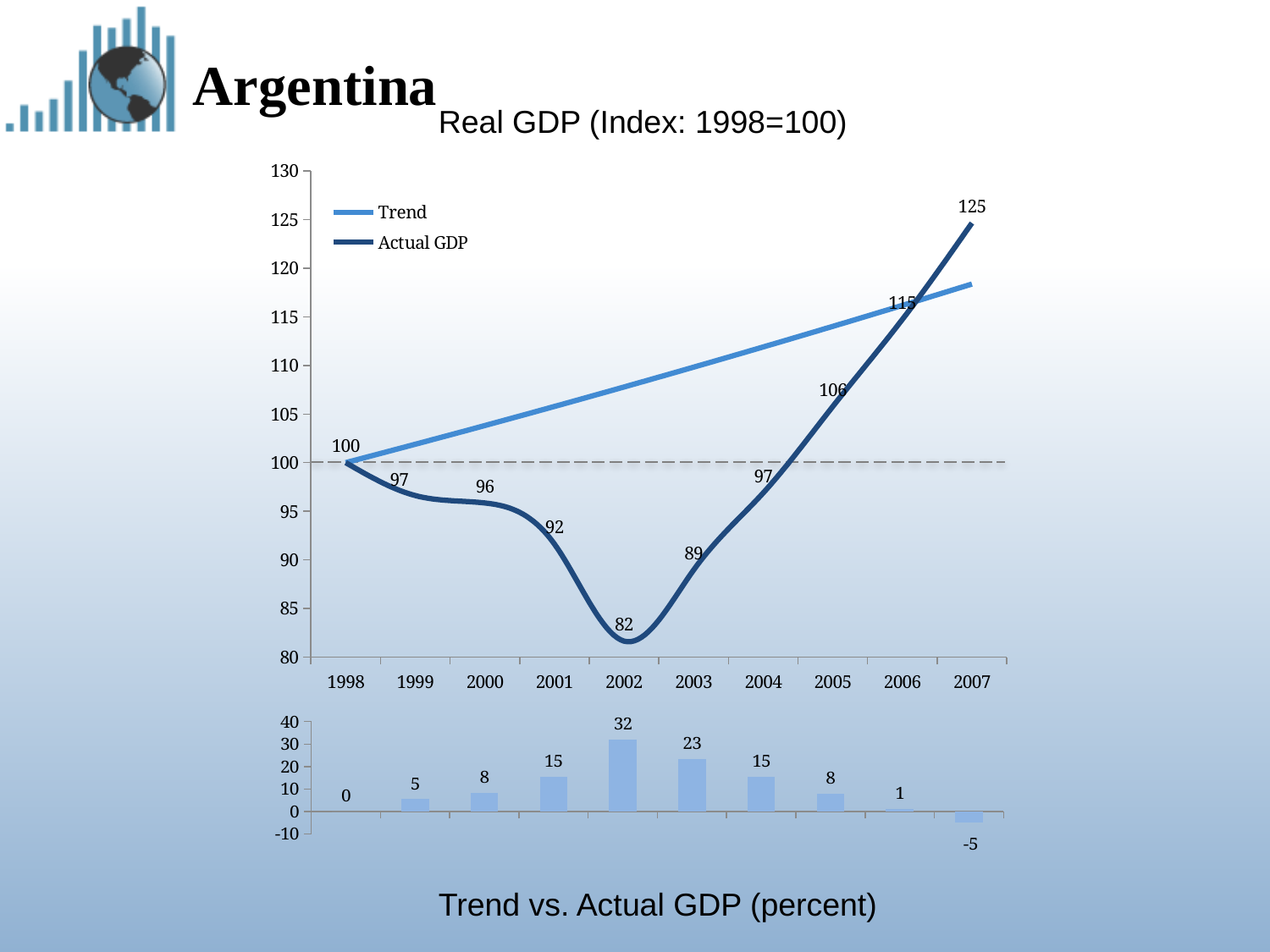
In the Real GDP (Index: 1998=100) chart, what is the Actual GDP value for 2007? 125 In the Real GDP (Index: 1998=100) chart, what is the difference between the Actual GDP values for 2007 and 2002? 43 In the Real GDP (Index: 1998=100) chart, which year has the lowest Actual GDP value? 2002 In the Real GDP (Index: 1998=100) chart, is the Trend value for 2007 greater or less than 115? greater In the Real GDP (Index: 1998=100) chart, what is the Actual GDP value for 2002? 82 In the Real GDP (Index: 1998=100) chart, how many series does the legend list? 2 What kind of chart is the Trend vs. Actual GDP (percent) chart at the bottom of the slide? bar chart In the Real GDP (Index: 1998=100) chart, which is larger in 2003: the Trend value or the Actual GDP value? Trend In the Trend vs. Actual GDP (percent) chart, how many years are shown? 10